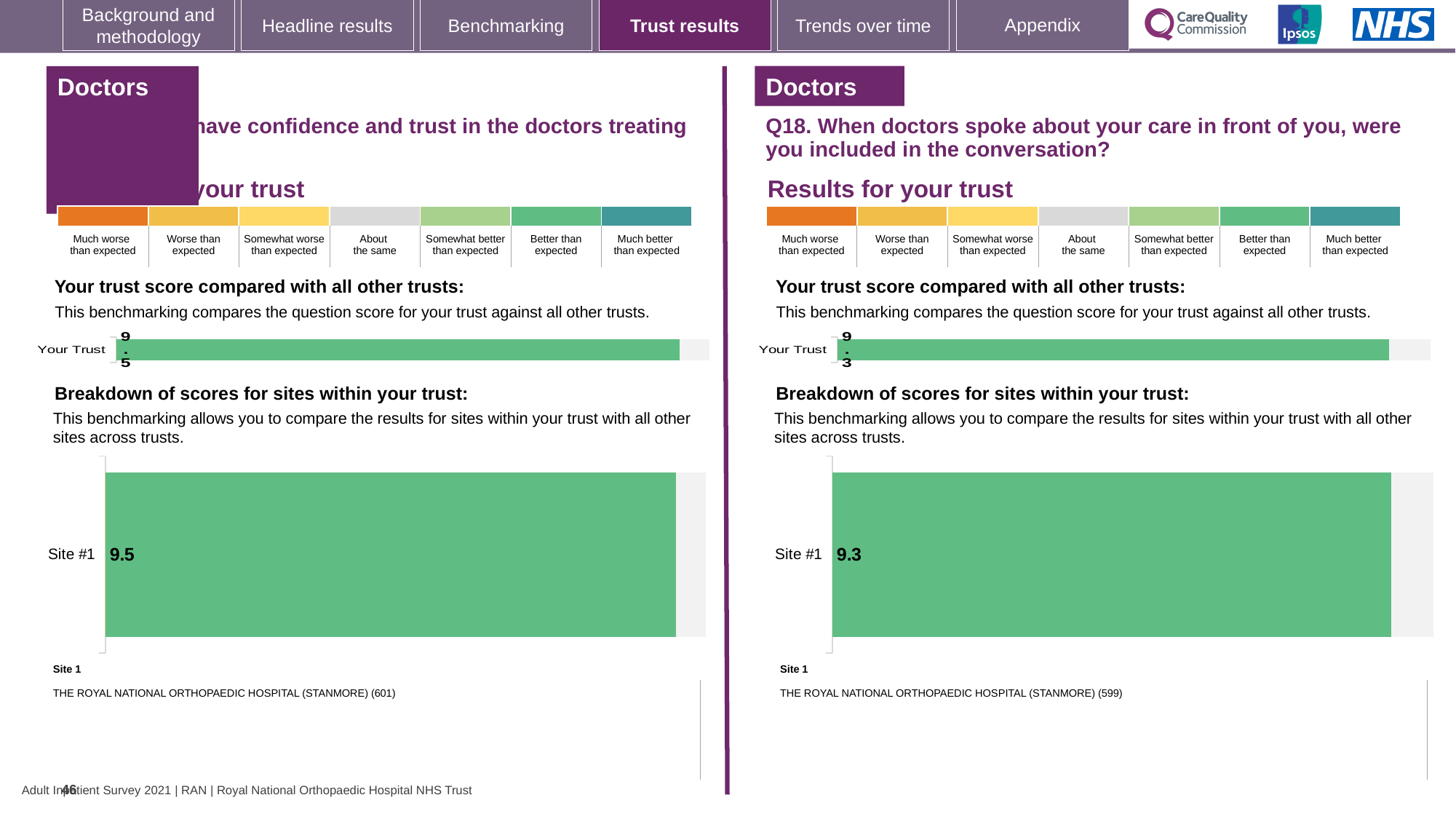
How many sites are shown in the 'Breakdown of scores for sites within your trust' chart on the left half of the slide? 1 What colour is the Site #1 bar in the breakdown chart on the left half of the slide? Green In the 'Breakdown of scores for sites within your trust' chart on the left half of the slide, what is the value for Site #1? 9.5 What type of chart is used to show the Site #1 score in the breakdown section on the right half of the slide (Q18)? Bar chart Which site is listed as Site 1 beneath the breakdown chart on the right half of the slide (Q18)? THE ROYAL NATIONAL ORTHOPAEDIC HOSPITAL (STANMORE) (599) On the right half of the slide (Q18), what is the score shown for Your Trust in the 'Your trust score compared with all other trusts' chart? 9.3 How many sites are shown in the 'Breakdown of scores for sites within your trust' chart on the right half of the slide (Q18)? 1 In the 'Breakdown of scores for sites within your trust' chart on the right half of the slide (Q18), what is the value for Site #1? 9.3 Which is larger: the Site #1 score in the left breakdown chart or the Site #1 score in the right (Q18) breakdown chart? The left chart (9.5) What is the difference between the Your Trust score on the left half of the slide and the Your Trust score on the right half (Q18)? 0.2 On the left half of the slide, what is the score shown for Your Trust in the 'Your trust score compared with all other trusts' chart? 9.5